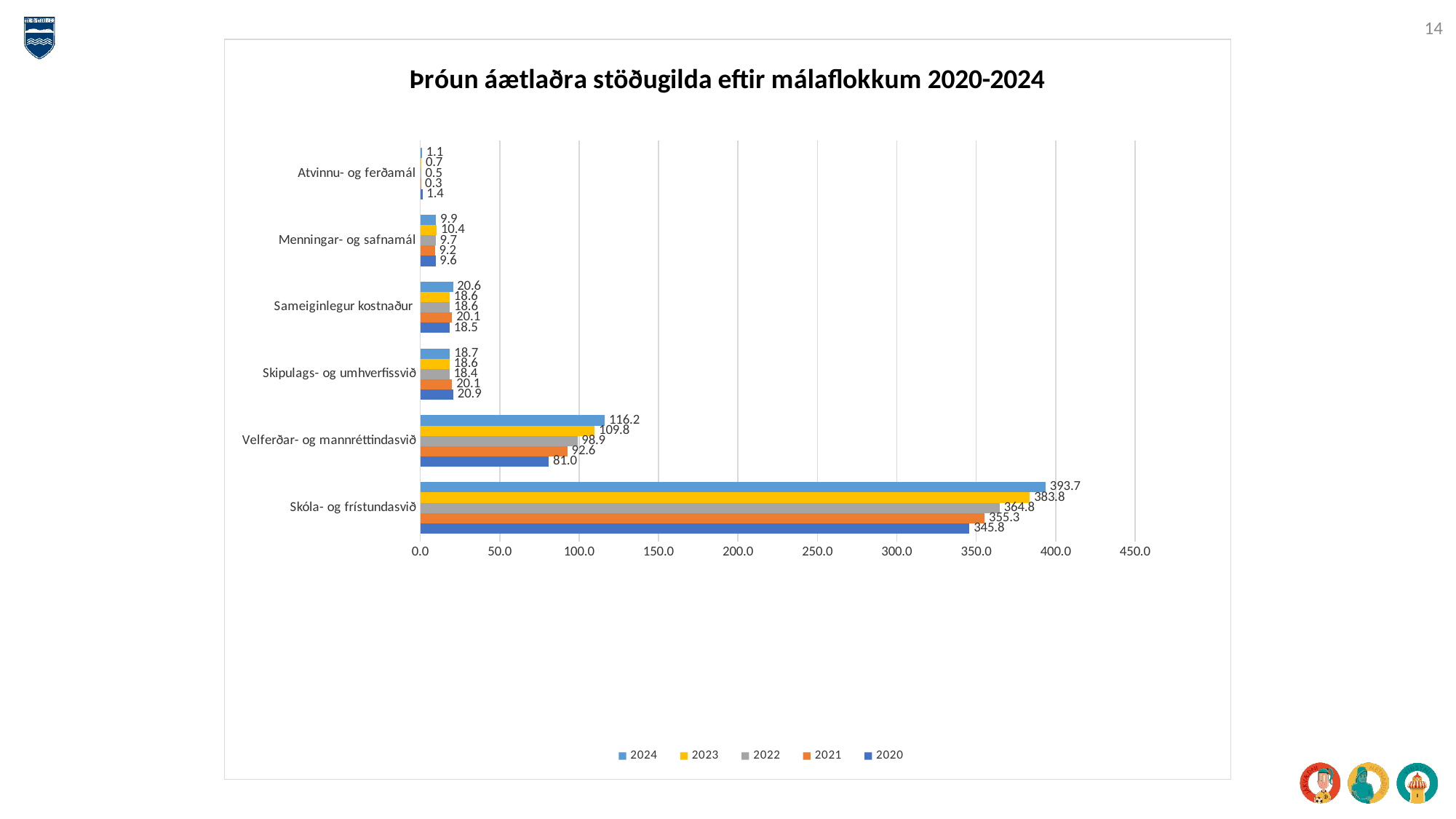
What is the 2023 value for Menningar- og safnamál? 10.4 What is the 2024 value for Skóla- og frístundasvið? 393.7 Which category has the highest 2024 value? Skóla- og frístundasvið Which category has the lowest 2021 value? Atvinnu- og ferðamál What is the 2020 value for Velferðar- og mannréttindasvið? 81.0 What is the difference between the 2024 and 2020 values for Skóla- og frístundasvið? 47.9 How many categories are shown on the chart? 6 What is the title of the chart? Þróun áætlaðra stöðugilda eftir málaflokkum 2020-2024 Which is larger for Skipulags- og umhverfissvið, the 2020 value or the 2024 value? 2020 How many series does the legend list? 5 What kind of chart is shown on the slide? Bar chart Is the 2023 value for Velferðar- og mannréttindasvið greater or less than 100.0? greater